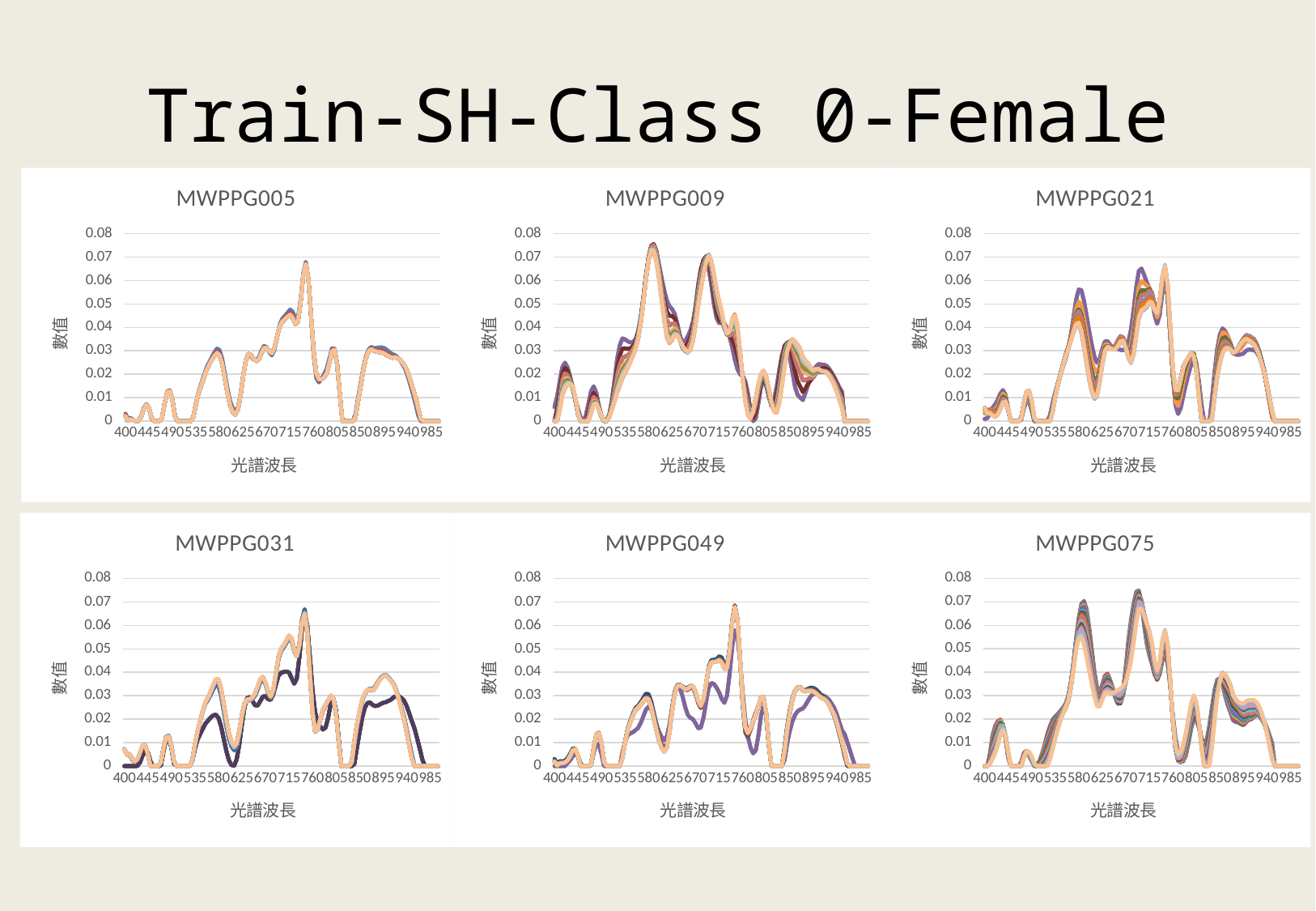
In the MWPPG049 chart, is the value at 400 greater or less than 0.01? less What is the title of the chart in the top-left position? MWPPG005 In the MWPPG009 chart, is the highest value reached by the lines greater or less than 0.07? greater In the MWPPG075 chart, is the highest value reached by the lines greater or less than 0.07? greater What kind of chart is MWPPG005? line chart What is the highest tick value shown on the y-axis of the MWPPG031 chart? 0.08 What is the x-axis title of the MWPPG075 chart? 光譜波長 How many charts are shown on the slide? 6